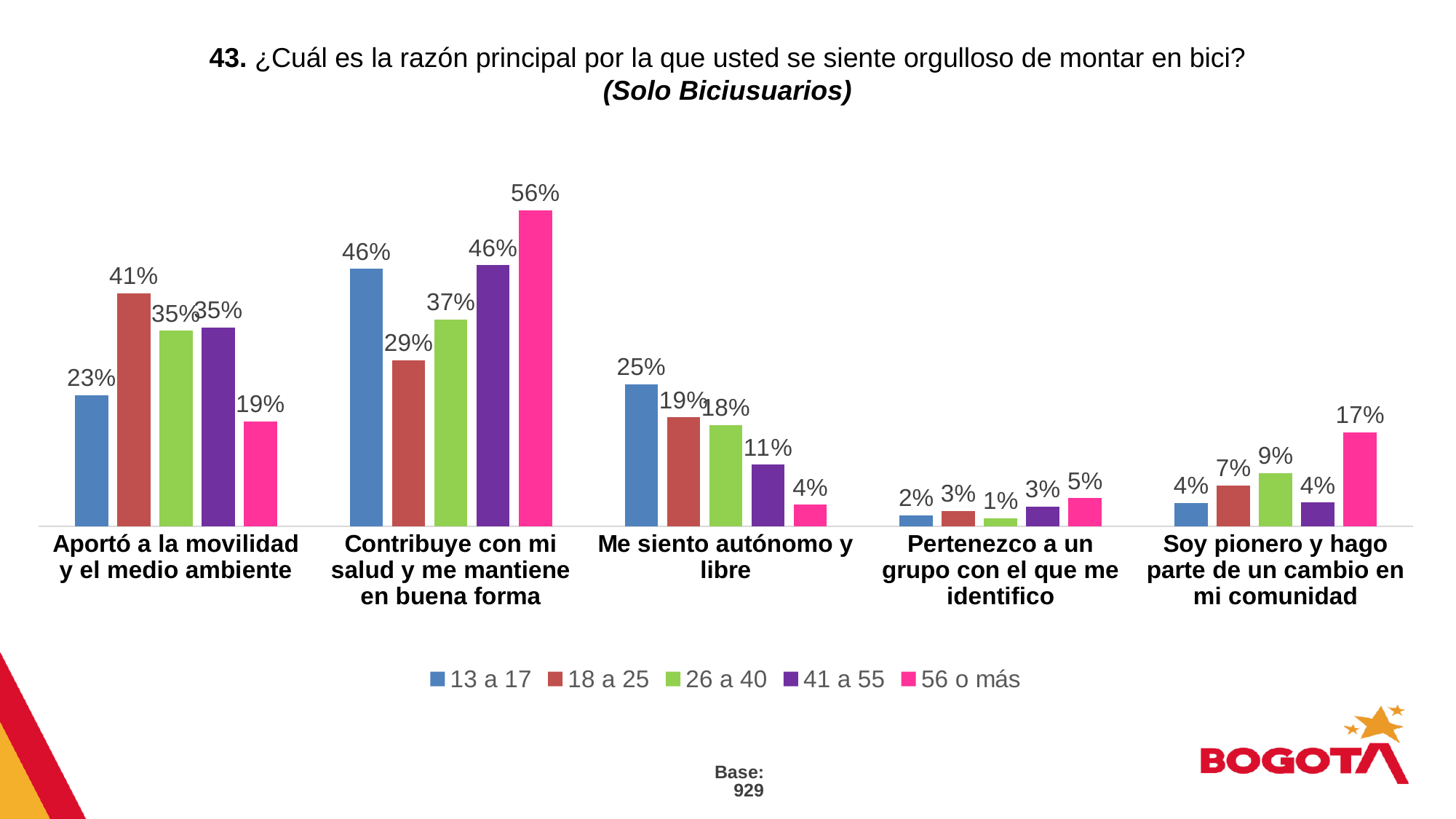
What kind of chart is shown on the slide? Bar chart What is the difference between the '56 o más' and '18 a 25' values in the 'Contribuye con mi salud y me mantiene en buena forma' category? 27% Which age group has the highest value in the 'Aportó a la movilidad y el medio ambiente' category? 18 a 25 What is the base (number of respondents) shown on the slide? 929 How many categories are shown on the x axis? 5 How many series does the legend list? 5 What is the value for the '13 a 17' series in the 'Aportó a la movilidad y el medio ambiente' category? 23% What is the value for the '41 a 55' series in the 'Me siento autónomo y libre' category? 11% What is the value for the '26 a 40' series in the 'Soy pionero y hago parte de un cambio en mi comunidad' category? 9% Which age group has the lowest value in the 'Pertenezco a un grupo con el que me identifico' category? 26 a 40 What is the value for the '56 o más' series in the 'Contribuye con mi salud y me mantiene en buena forma' category? 56% In the 'Me siento autónomo y libre' category, which is larger: the value for '13 a 17' or the value for '56 o más'? 13 a 17